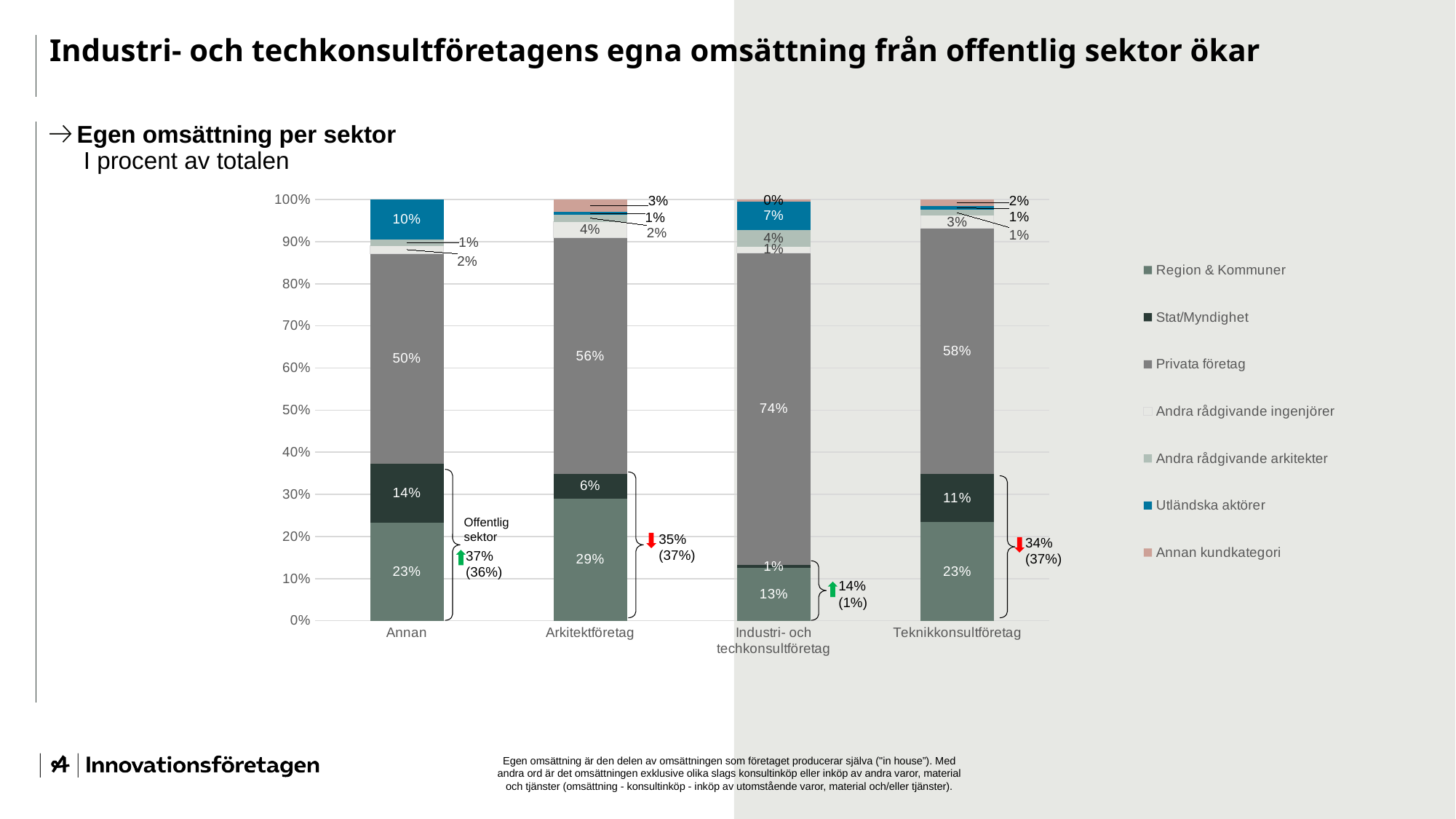
What is the difference between the Privata företag values for Teknikkonsultföretag and Arkitektföretag? 2 percentage points What is the value for Stat/Myndighet in the Teknikkonsultföretag bar? 11% What is the value for Utländska aktörer in the Annan bar? 10% What is the Offentlig sektor share annotated for Industri- och techkonsultföretag? 14% Which has a larger Region & Kommuner value, Annan or Arkitektföretag? Arkitektföretag How many categories are shown on the x axis? 4 What kind of chart is shown on the slide? Stacked bar chart What is the value for Privata företag in the Industri- och techkonsultföretag bar? 74% Which category has the lowest value for Stat/Myndighet? Industri- och techkonsultföretag What is the value for Region & Kommuner in the Arkitektföretag bar? 29% How many series does the legend list? 7 Which category has the highest value for Privata företag? Industri- och techkonsultföretag